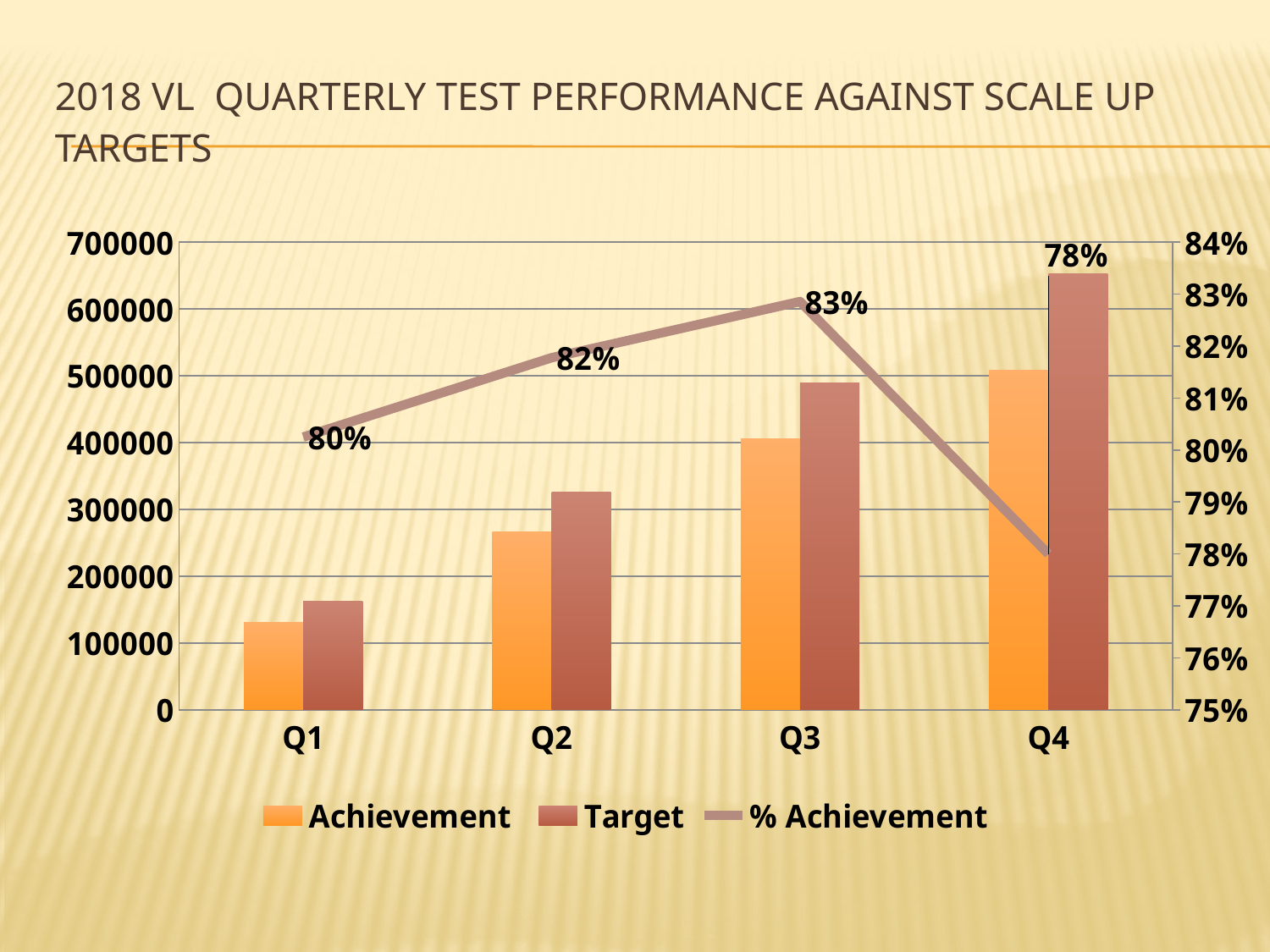
What is the % Achievement value for Q3? 83% What is the % Achievement value for Q1? 80% What is the % Achievement value for Q4? 78% How many quarters are shown on the x axis? 4 Is the Target value for Q4 greater or less than 600000? greater Is the Achievement value for Q1 greater or less than 200000? less In Q2, which is larger, the Achievement bar or the Target bar? Target How many series does the legend list? 3 What is the difference between the % Achievement in Q3 and in Q4? 5% Which quarter has the lowest % Achievement? Q4 Which quarter has the highest % Achievement? Q3 Does the Target series rise or fall from Q1 to Q4? rise